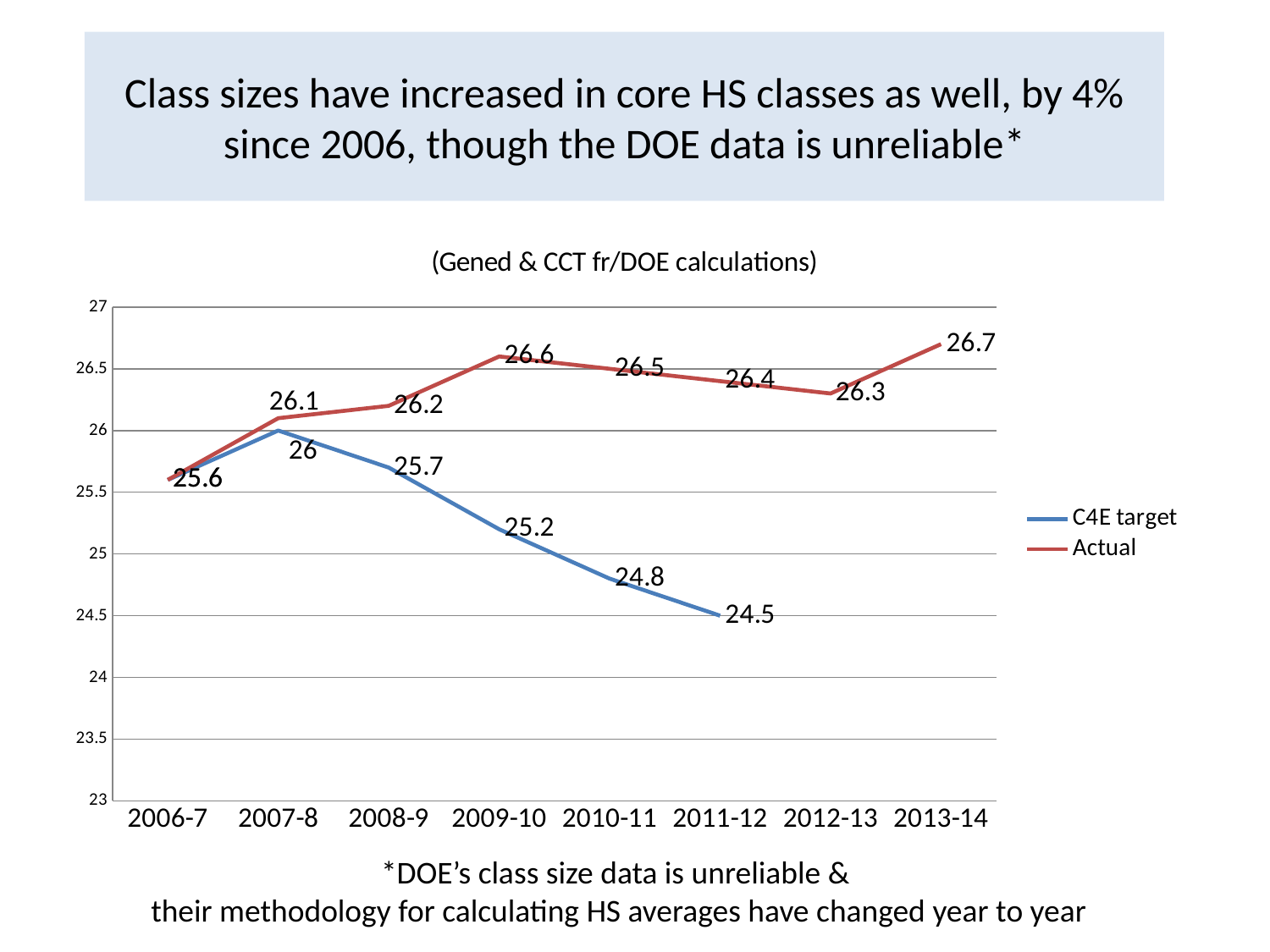
In which year is the Actual value highest? 2013-14 What are the two series named in the legend? C4E target and Actual What is the Actual value for 2013-14? 26.7 In which year is the C4E target value lowest? 2011-12 What is the Actual value for 2009-10? 26.6 How many school years are shown on the x axis? 8 How many series does the legend list? 2 What is the C4E target value for 2011-12? 24.5 What is the difference between the Actual value and the C4E target in 2011-12? 1.9 What kind of chart is shown on the slide? Line chart Does the C4E target rise or fall from 2007-8 to 2011-12? Fall In 2009-10, which is larger: the Actual value or the C4E target? Actual